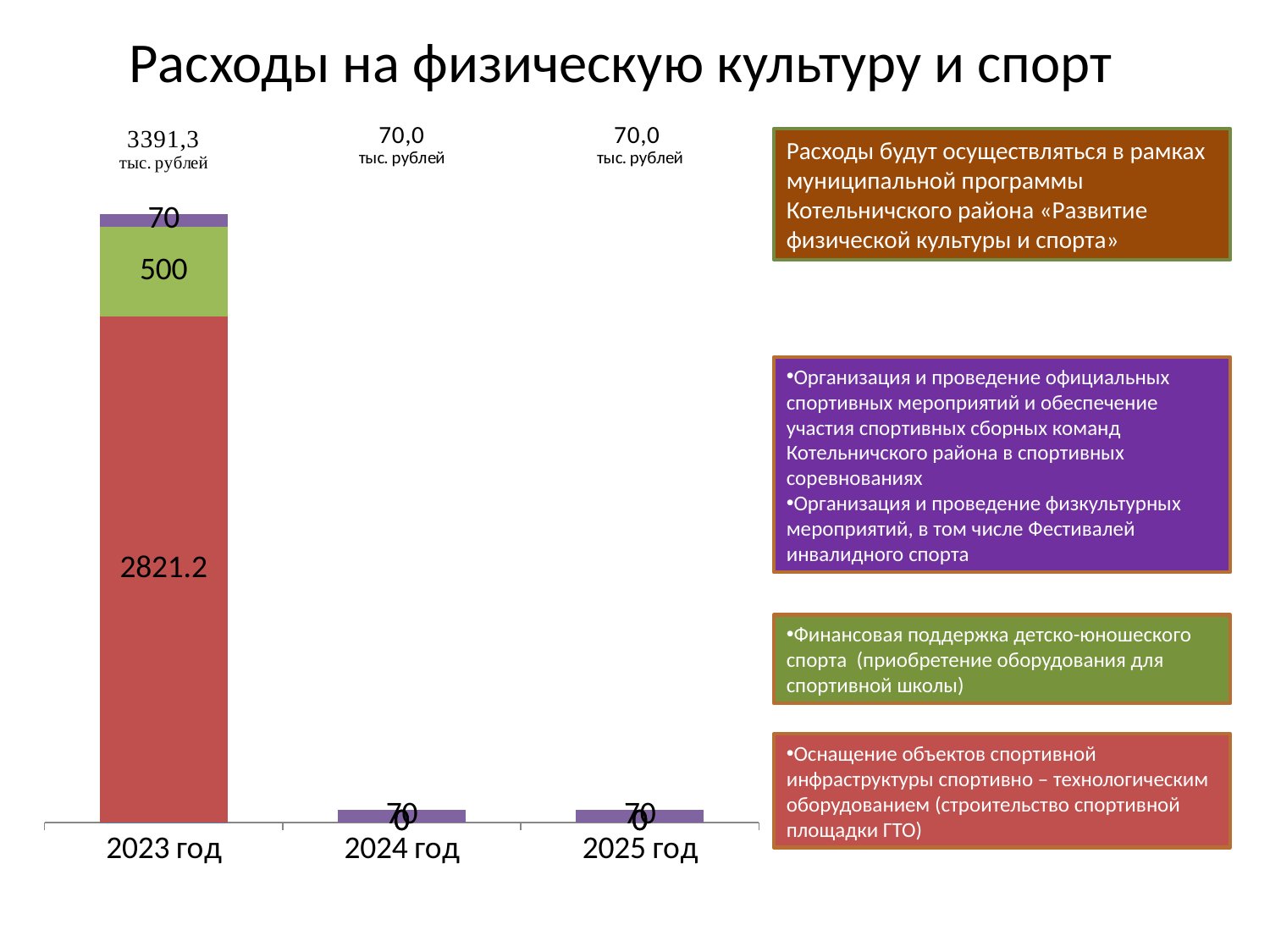
What is the title of the slide above the chart? Расходы на физическую культуру и спорт What total is printed above the bar for 2025 год? 70,0 тыс. рублей What is the value of the purple segment for 2023 год? 70 What total is printed above the bar for 2023 год? 3391,3 тыс. рублей Which is larger: the green segment for 2023 год or the purple segment for 2023 год? the green segment (500) How many year categories are shown on the x axis of the chart? 3 What is the value of the green segment for 2023 год? 500 Which year has the highest total expenditure in the chart? 2023 год What is the value of the purple segment for 2024 год? 70 What is the difference between the red segment (2821.2) and the green segment (500) for 2023 год? 2321.2 What kind of chart is shown on the slide? bar chart What is the value of the red segment for 2023 год? 2821.2